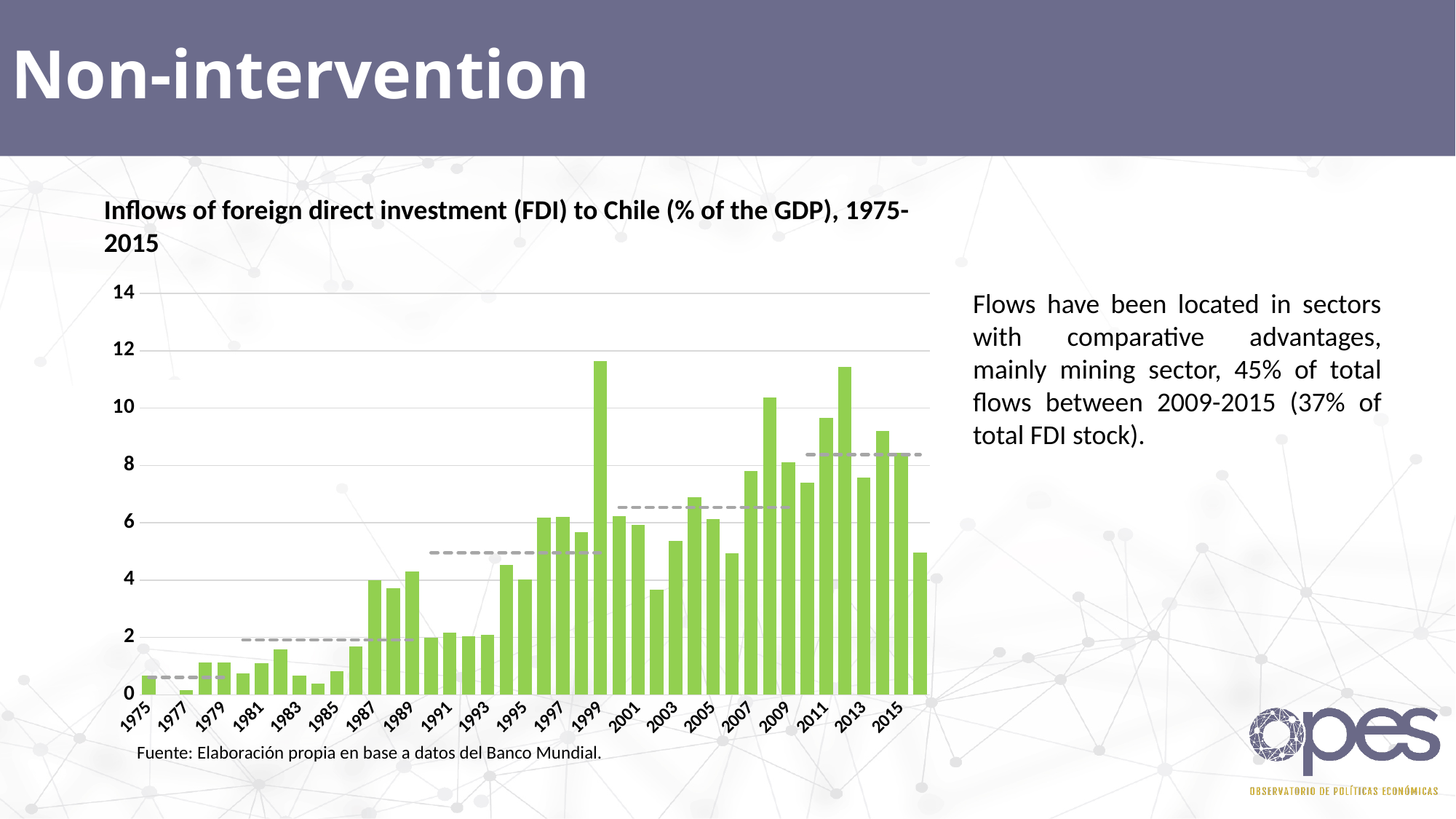
Which year has the larger value, 1985 or 1987? 1987 Is the value for 1999 greater or less than 10? greater Is the value for 2003 greater or less than 6? less What source is cited below the chart? Fuente: Elaboración propia en base a datos del Banco Mundial. What is the title of the chart? Inflows of foreign direct investment (FDI) to Chile (% of the GDP), 1975-2015 Is the value for 1987 greater or less than 2? greater Which year has the larger value, 1999 or 2015? 1999 Do the values generally rise or fall from 1975 to 1999? rise What kind of chart is shown on the slide? bar chart